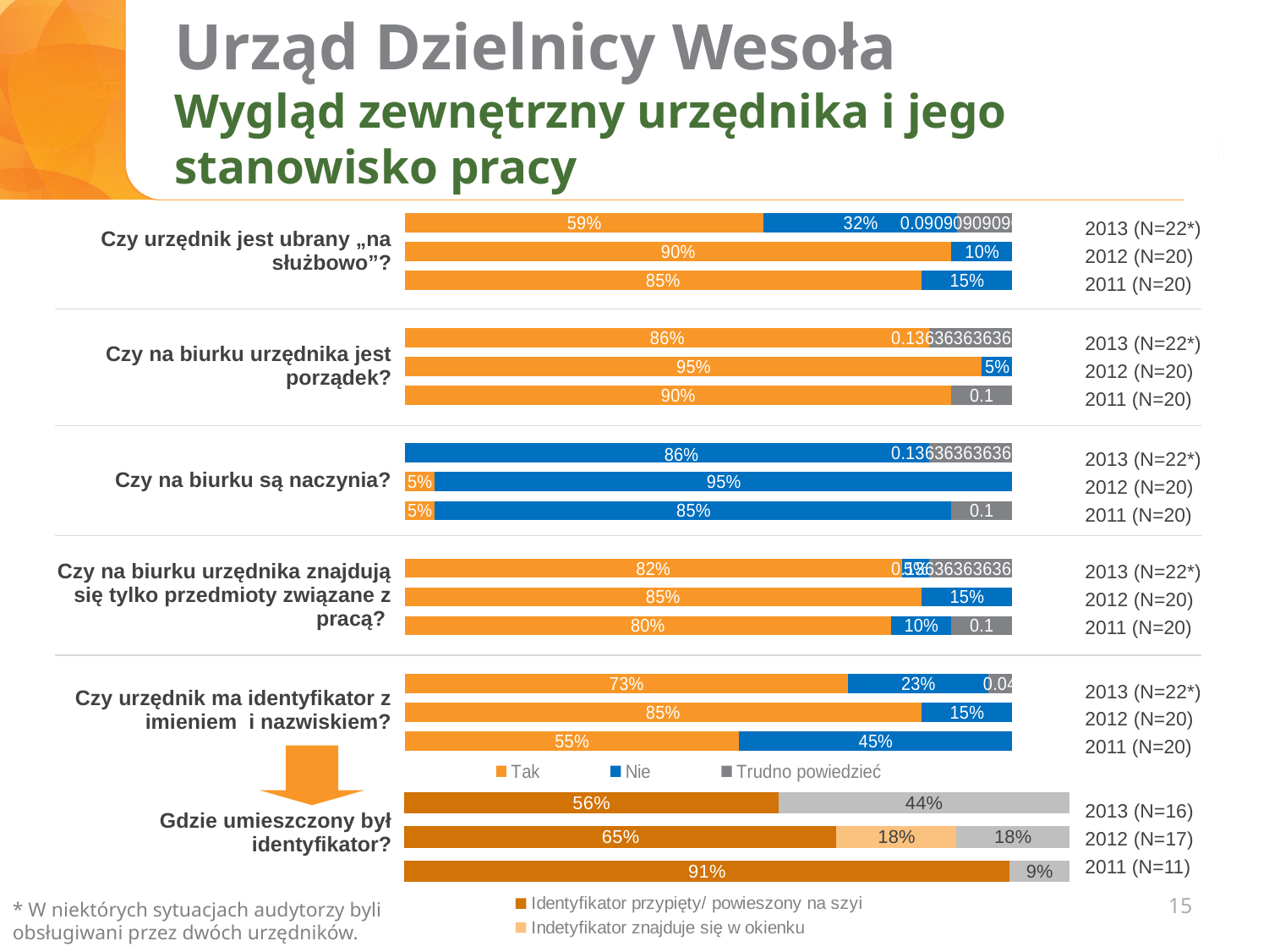
In the chart "Czy urzędnik ma identyfikator z imieniem i nazwiskiem?", what is the "Nie" value for 2011 (N=20)? 45% In the chart "Gdzie umieszczony był identyfikator?", what is the value for "Identyfikator przypięty/ powieszony na szyi" in 2011 (N=11)? 91% In the chart "Czy na biurku są naczynia?", what is the "Tak" value for 2011 (N=20)? 5% In the chart "Czy urzędnik jest ubrany „na służbowo”?", what is the "Nie" value for 2012 (N=20)? 10% In the chart "Czy na biurku urzędnika jest porządek?", what is the difference between the "Tak" values for 2012 (N=20) and 2011 (N=20)? 5% In the chart "Czy na biurku są naczynia?", what is the "Nie" value for 2012 (N=20)? 95% What type of chart is used for "Czy urzędnik ma identyfikator z imieniem i nazwiskiem?"? Stacked bar chart In the chart "Czy na biurku urzędnika jest porządek?", what is the "Tak" value for 2012 (N=20)? 95% In the chart "Czy urzędnik ma identyfikator z imieniem i nazwiskiem?", which year has the lowest "Tak" value? 2011 (N=20) In the chart "Czy urzędnik jest ubrany „na służbowo”?", what is the "Tak" value for 2013 (N=22*)? 59% In the chart "Czy urzędnik jest ubrany „na służbowo”?", which year has the highest "Tak" value? 2012 (N=20) In the chart "Gdzie umieszczony był identyfikator?", is the "Identyfikator przypięty/ powieszony na szyi" value larger in 2013 (N=16) or 2012 (N=17)? 2012 (N=17)